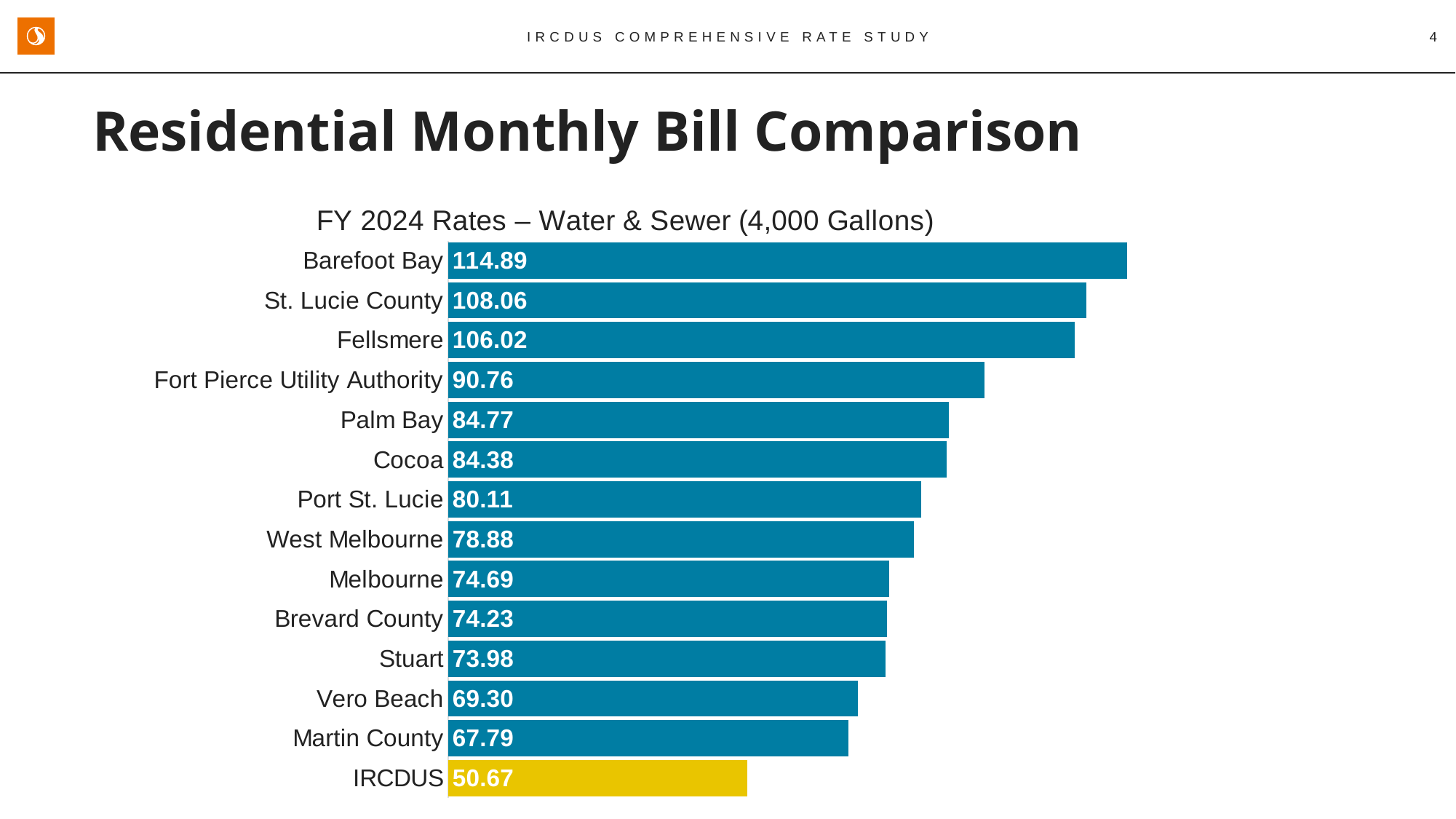
What is the value for IRCDUS? 50.67 What is the title of the chart? FY 2024 Rates – Water & Sewer (4,000 Gallons) What is the value for Barefoot Bay? 114.89 Which is larger, the value for Port St. Lucie or the value for West Melbourne? Port St. Lucie What kind of chart is shown on the slide? Bar chart How many categories are shown in the chart? 14 What is the value for Vero Beach? 69.30 What is the difference between the values for Barefoot Bay and IRCDUS? 64.22 Which category has the lowest value? IRCDUS What is the difference between the values for St. Lucie County and Fellsmere? 2.04 Which category has the highest value? Barefoot Bay What is the value for Fort Pierce Utility Authority? 90.76